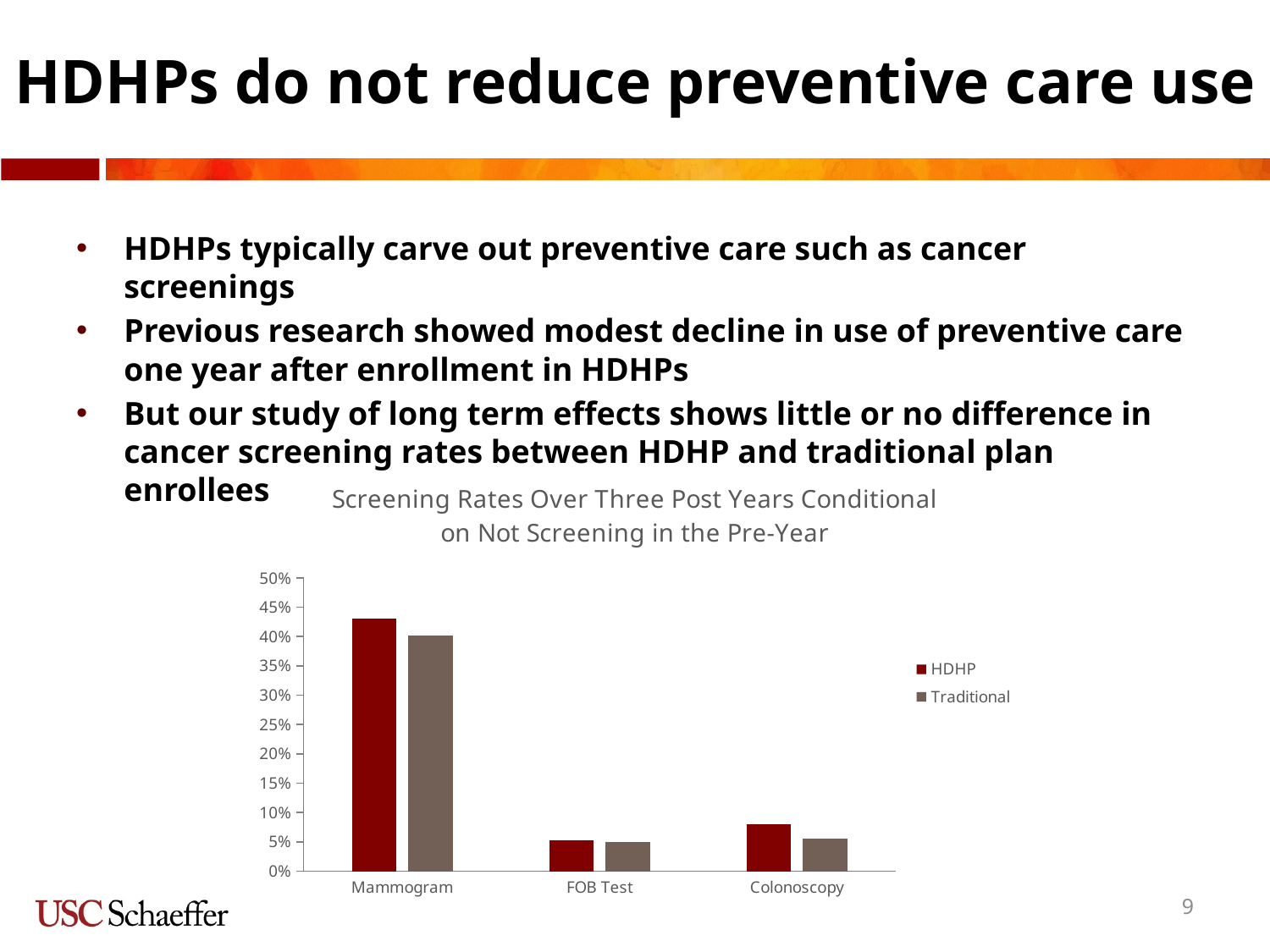
For Mammogram, which series has the higher screening rate, HDHP or Traditional? HDHP Which series is shown in dark red in the chart? HDHP For Colonoscopy, which series has the higher screening rate, HDHP or Traditional? HDHP How many screening categories are shown on the x axis of the chart? 3 How many series does the chart's legend list? 2 What kind of chart is shown on the slide? bar chart What is the title of the chart? Screening Rates Over Three Post Years Conditional on Not Screening in the Pre-Year Is the HDHP value for FOB Test greater or less than 10%? less Which screening category has the highest HDHP screening rate? Mammogram Which screening category has the lowest HDHP screening rate? FOB Test Is the HDHP value for Mammogram greater or less than 40%? greater Is the HDHP value for Colonoscopy greater or less than 5%? greater